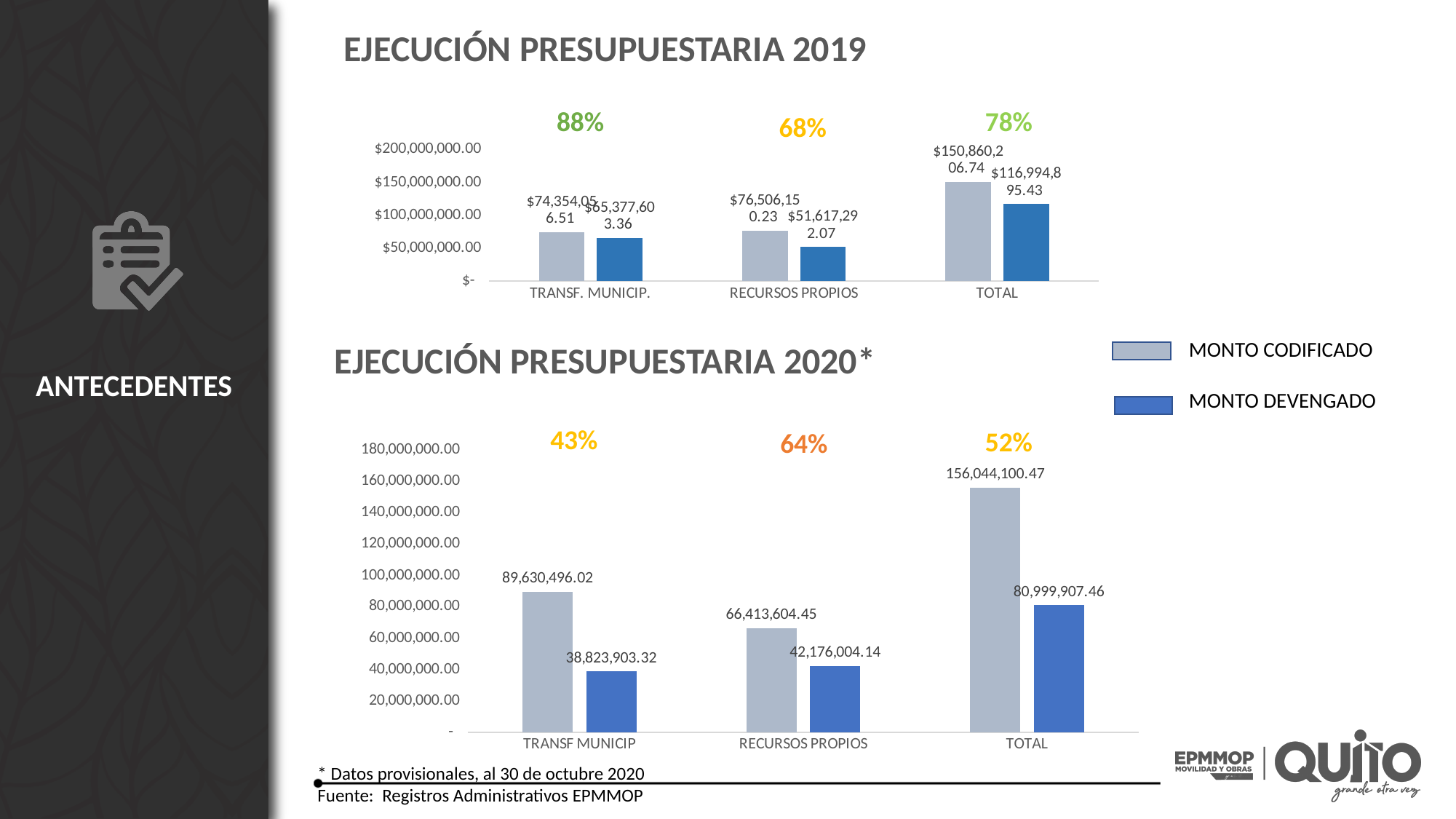
In the EJECUCIÓN PRESUPUESTARIA 2019 chart, is the MONTO CODIFICADO value for TOTAL greater or less than $150,000,000.00? greater In the EJECUCIÓN PRESUPUESTARIA 2020* chart, which category has the lowest MONTO DEVENGADO value? TRANSF MUNICIP In the EJECUCIÓN PRESUPUESTARIA 2019 chart, what is the MONTO DEVENGADO value for TOTAL? $116,994,895.43 In the EJECUCIÓN PRESUPUESTARIA 2020* chart, what is the MONTO DEVENGADO value for TRANSF MUNICIP? 38,823,903.32 In the EJECUCIÓN PRESUPUESTARIA 2020* chart, what is the MONTO CODIFICADO value for RECURSOS PROPIOS? 66,413,604.45 In the EJECUCIÓN PRESUPUESTARIA 2020* chart, which is larger: the MONTO CODIFICADO for TRANSF MUNICIP or for RECURSOS PROPIOS? TRANSF MUNICIP In the EJECUCIÓN PRESUPUESTARIA 2020* chart, what is the MONTO DEVENGADO value for TOTAL? 80,999,907.46 In the EJECUCIÓN PRESUPUESTARIA 2020* chart, what is the difference between the MONTO CODIFICADO and MONTO DEVENGADO values for TOTAL? 75,044,193.01 What kind of chart is EJECUCIÓN PRESUPUESTARIA 2020*? bar chart In the EJECUCIÓN PRESUPUESTARIA 2019 chart, what execution percentage is shown above TRANSF. MUNICIP.? 88% How many series does the legend list for the charts on this slide? 2 In the EJECUCIÓN PRESUPUESTARIA 2020* chart, what is the MONTO CODIFICADO value for TOTAL? 156,044,100.47